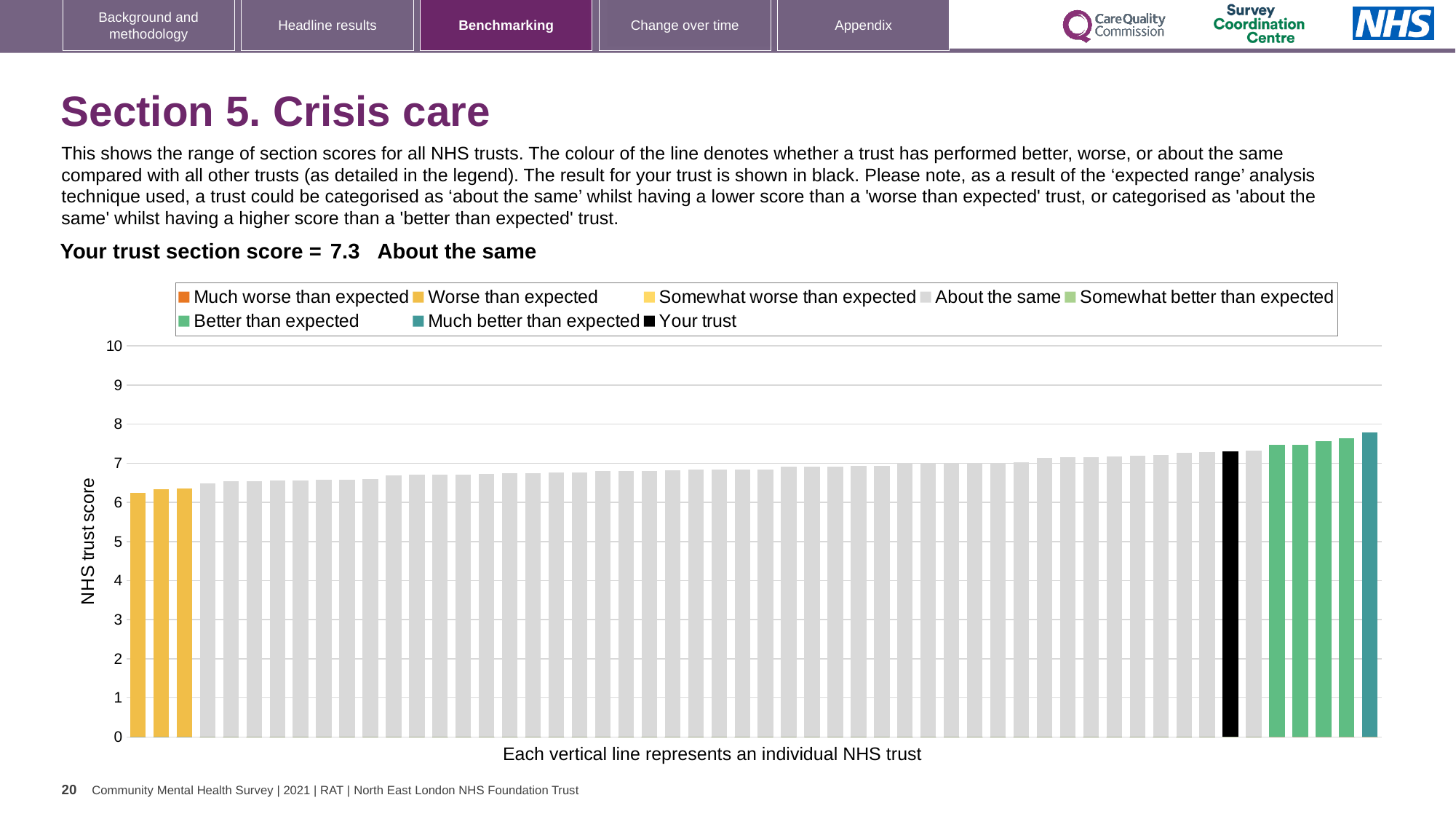
What type of chart is shown on the slide? Bar chart Which category is your trust placed in for this section? About the same Is the value of the rightmost (highest) bar greater or less than 8? less How many bars are coloured as 'Worse than expected' (yellow)? 3 What is the title of the y axis? NHS trust score What is the section score for your trust shown on the slide? 7.3 What colour is the bar representing your trust? Black Is the value of the rightmost (highest) bar greater or less than 7? greater How many entries does the chart legend list? 8 Is the value of the leftmost (lowest) bar greater or less than 7? less Do the bar values rise or fall from left to right along the x axis? Rise How many bars are coloured as 'Better than expected' (green)? 4